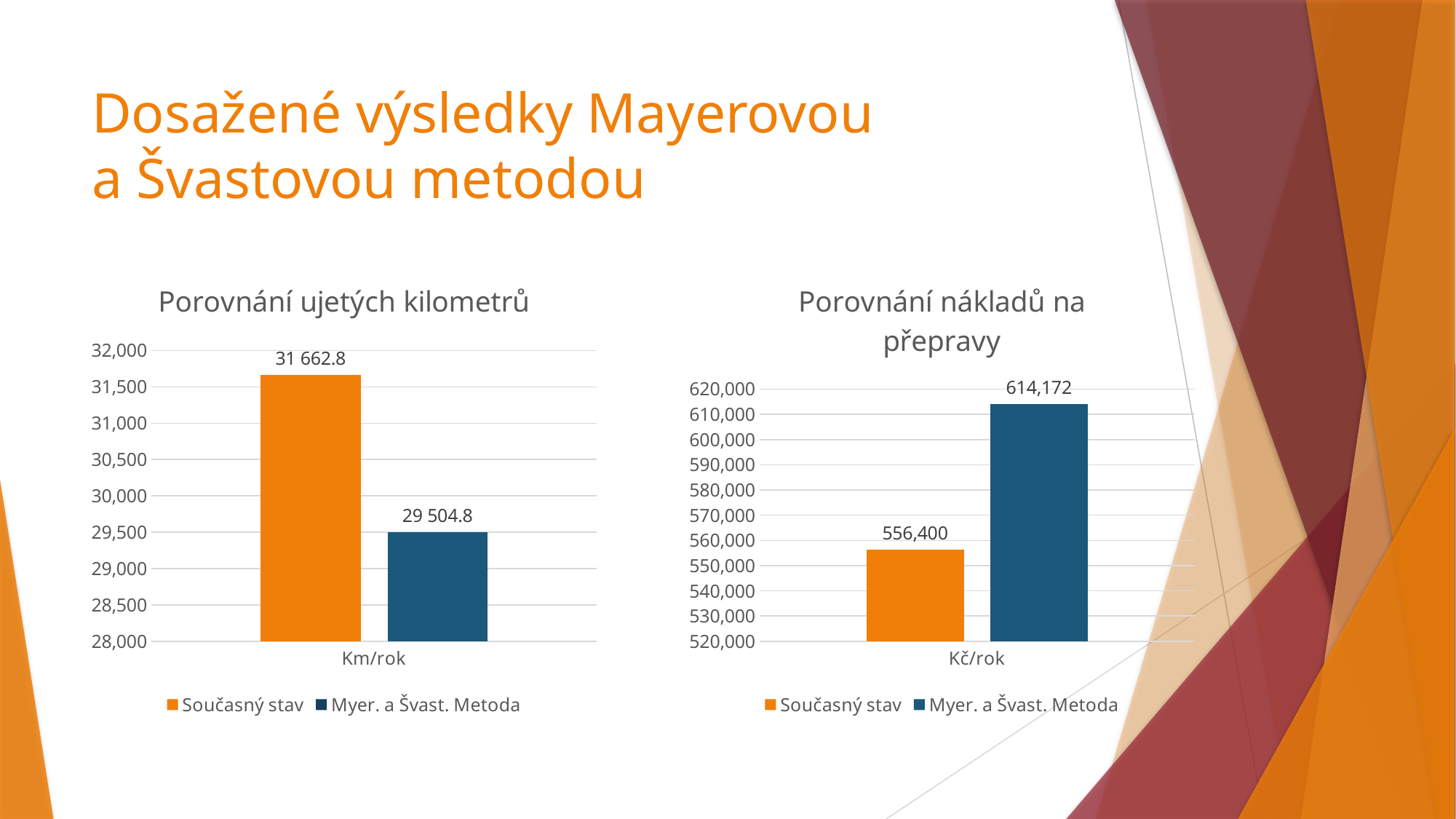
In the chart 'Porovnání ujetých kilometrů', what is the value for Současný stav? 31 662.8 In the chart 'Porovnání nákladů na přepravy', is the value for Myer. a Švast. Metoda greater or less than 600,000? greater In the chart 'Porovnání nákladů na přepravy', what is the value for Myer. a Švast. Metoda? 614,172 In the chart 'Porovnání nákladů na přepravy', which series has the lower value? Současný stav In the chart 'Porovnání ujetých kilometrů', what is the value for Myer. a Švast. Metoda? 29 504.8 In the chart 'Porovnání ujetých kilometrů', what is the difference between Současný stav and Myer. a Švast. Metoda? 2 158 What kind of chart is 'Porovnání nákladů na přepravy'? bar chart In the chart 'Porovnání nákladů na přepravy', what is the value for Současný stav? 556,400 In the chart 'Porovnání nákladů na přepravy', what is the difference between Myer. a Švast. Metoda and Současný stav? 57,772 How many series does the legend of the chart 'Porovnání ujetých kilometrů' list? 2 In the chart 'Porovnání ujetých kilometrů', which series has the higher value? Současný stav What is the x-axis category label in the chart 'Porovnání nákladů na přepravy'? Kč/rok